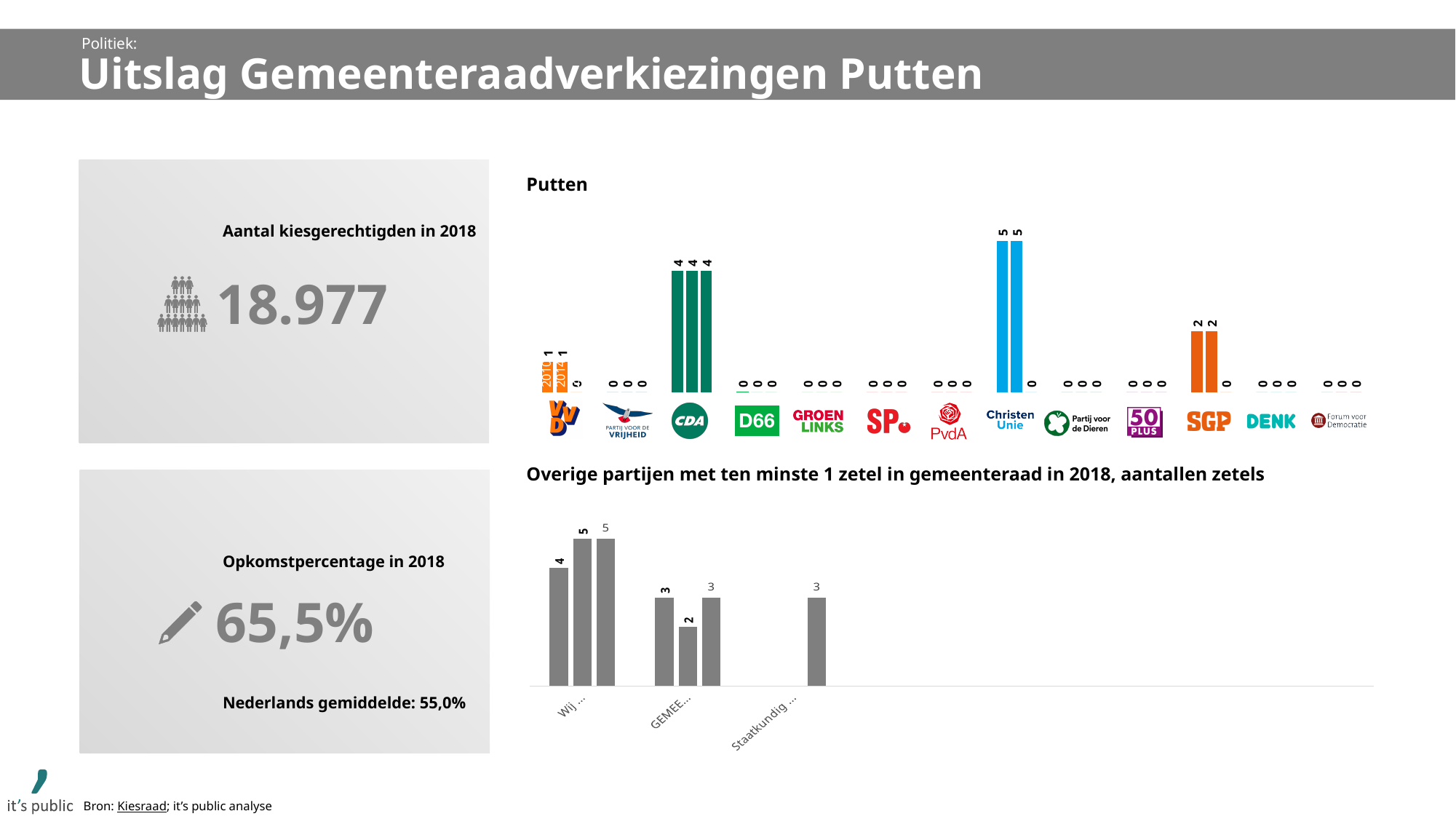
In the 'Overige partijen' chart, what is the value of the middle bar in the second group (GEMEE...)? 2 In the 'Putten' chart, what is the difference between the 2010 bar for ChristenUnie and the 2010 bar for SGP? 3 In the 'Overige partijen' chart, what is the value of the single bar for the third group (Staatkundig ...)? 3 In the 'Putten' chart, what is the value of the first (2010) bar for ChristenUnie? 5 In the 'Putten' chart, which party has the highest bar? ChristenUnie In the 'Putten' chart, how many seats does CDA have in each of the three bars shown? 4, 4, 4 In the 'Putten' chart, which is larger: the 2010 bar for CDA or the 2010 bar for SGP? CDA What kind of chart is the 'Putten' chart? Bar chart In the 'Putten' chart, what is the value of the first (2010) bar for SGP? 2 In the 'Putten' chart, what is the value of the first (2010) bar for VVD? 1 In the 'Putten' chart, how many parties are shown along the x axis? 13 In the 'Overige partijen' chart, what are the three values for the first group of bars (Wij ...)? 4, 5, 5